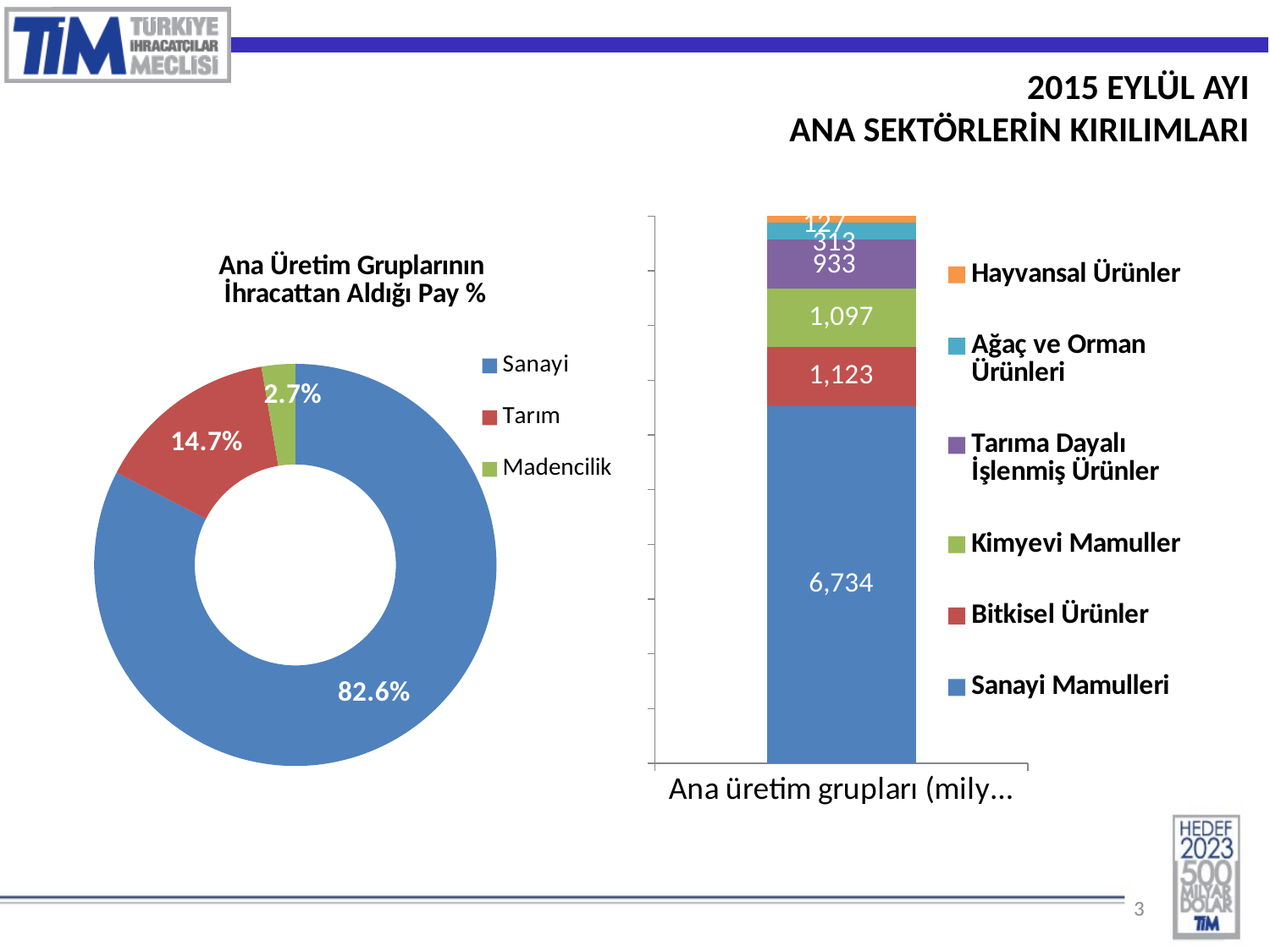
In the stacked bar chart on the right, what is the value for Sanayi Mamulleri? 6,734 In the stacked bar chart on the right, what is the difference between Bitkisel Ürünler and Kimyevi Mamuller? 26 In the doughnut chart 'Ana Üretim Gruplarının İhracattan Aldığı Pay %', what share does Tarım have? 14.7% In the stacked bar chart on the right, how many series does the legend list? 6 In the doughnut chart 'Ana Üretim Gruplarının İhracattan Aldığı Pay %', which group has the largest share? Sanayi In the stacked bar chart on the right, what is the value for Kimyevi Mamuller? 1,097 In the doughnut chart 'Ana Üretim Gruplarının İhracattan Aldığı Pay %', how many groups are shown? 3 In the doughnut chart 'Ana Üretim Gruplarının İhracattan Aldığı Pay %', what share does Madencilik have? 2.7% In the doughnut chart 'Ana Üretim Gruplarının İhracattan Aldığı Pay %', which group has the smallest share? Madencilik In the stacked bar chart on the right, what is the value for Bitkisel Ürünler? 1,123 In the stacked bar chart on the right, what is the value for Tarıma Dayalı İşlenmiş Ürünler? 933 In the doughnut chart 'Ana Üretim Gruplarının İhracattan Aldığı Pay %', what share does Sanayi have? 82.6%